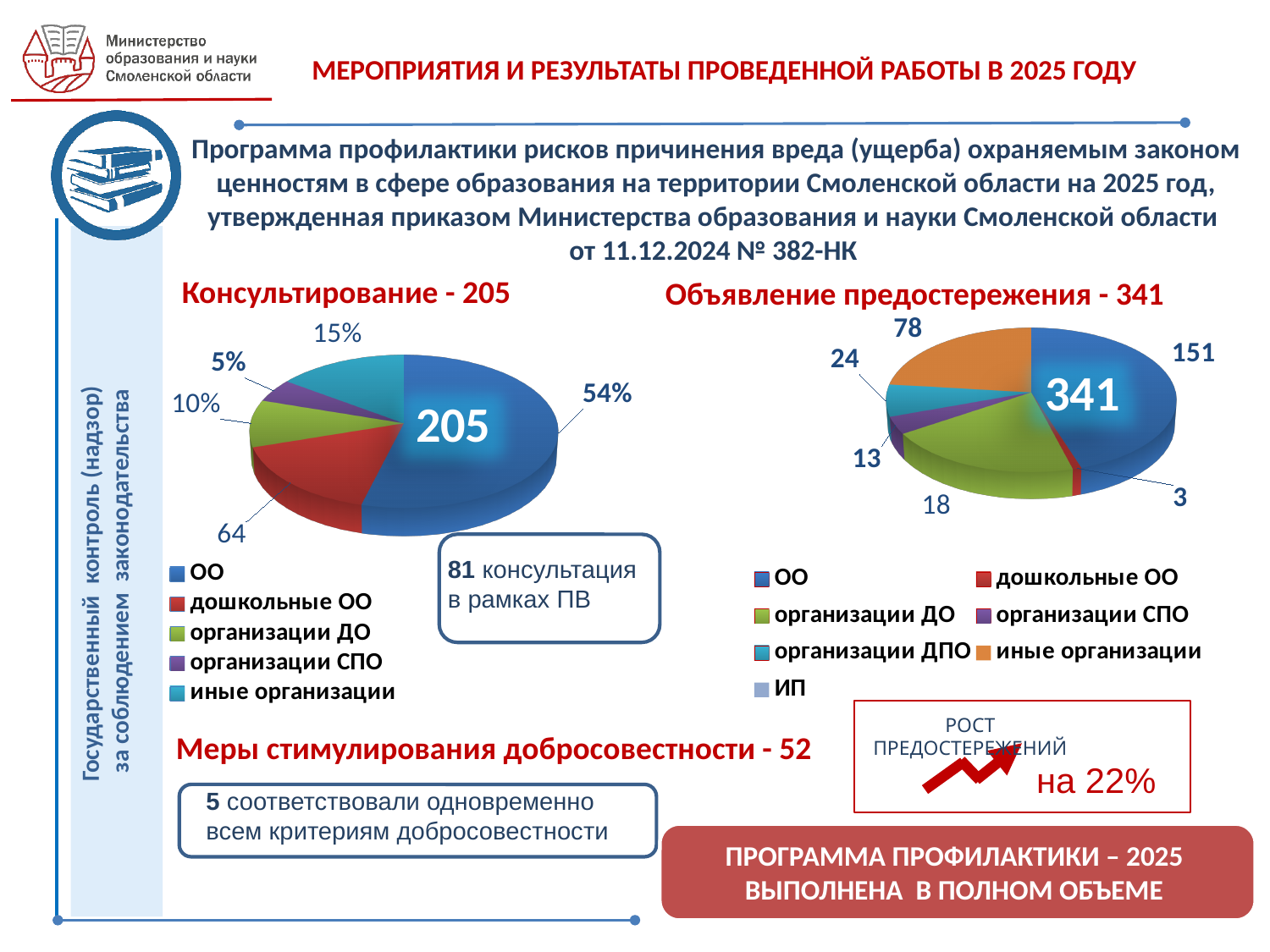
How many entries does the legend of the chart 'Объявление предостережения - 341' list? 7 In the chart 'Консультирование - 205', what share is shown for иные организации? 15% How many entries does the legend of the chart 'Консультирование - 205' list? 5 In the chart 'Объявление предостережения - 341', what is the value for ОО? 151 What kind of chart is 'Консультирование - 205'? pie chart In the chart 'Консультирование - 205', what share is shown for ОО? 54% In the chart 'Консультирование - 205', what share is shown for организации СПО? 5% In the chart 'Объявление предостережения - 341', which category has the largest value? ОО In the chart 'Объявление предостережения - 341', what is the value for иные организации? 78 In the chart 'Объявление предостережения - 341', what is the difference between the values for ОО and иные организации? 73 In the chart 'Объявление предостережения - 341', what is the value for дошкольные ОО? 3